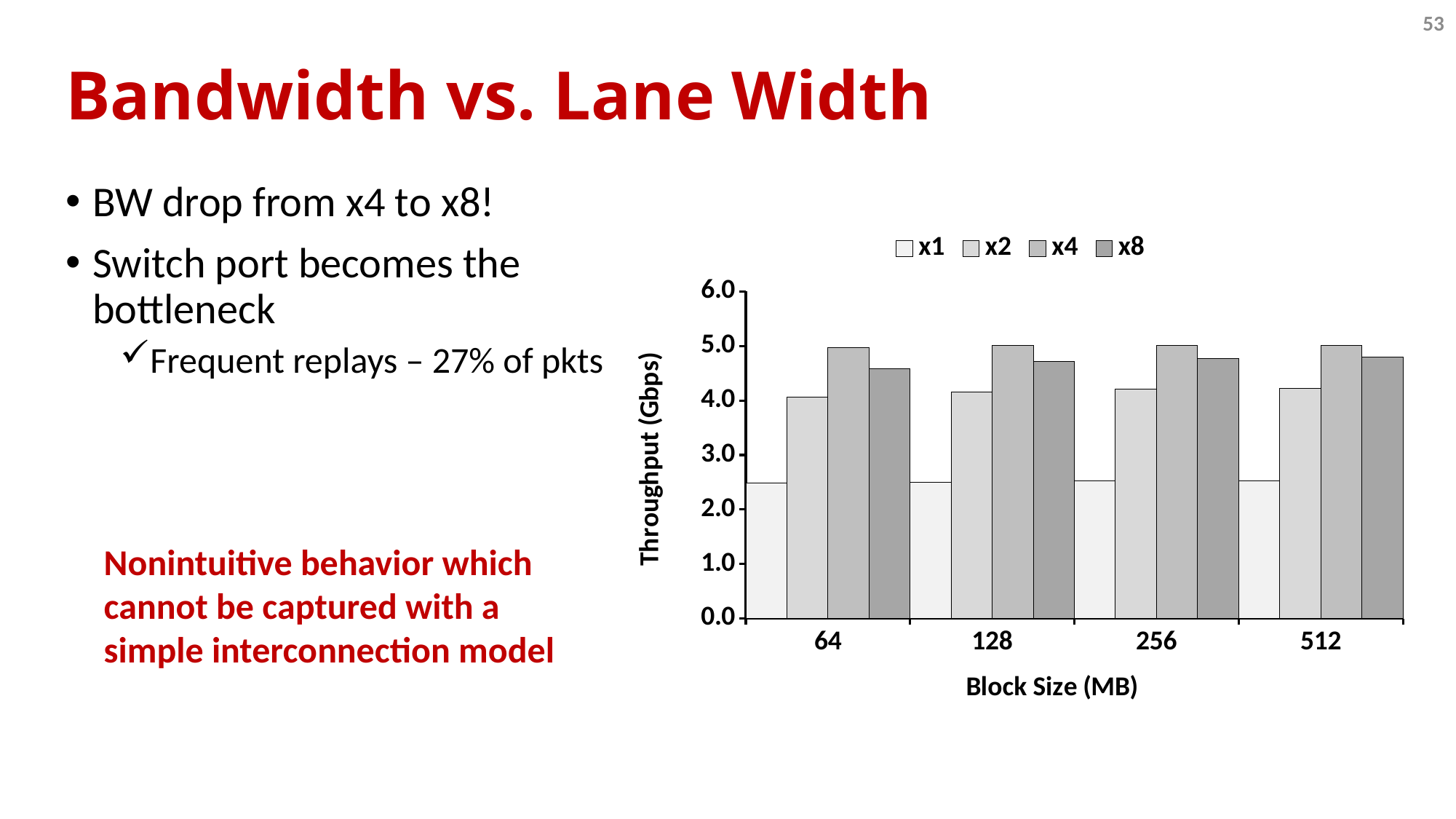
What is the label of the y axis? Throughput (Gbps) Is the throughput for x4 at block size 128 greater or less than 4.0? greater At block size 64, which is larger: the throughput for x4 or for x8? x4 Is the throughput for x1 at block size 64 greater or less than 3.0? less Which series has the lowest throughput at block size 256? x1 Is the throughput for x8 at block size 512 greater or less than 4.0? greater What kind of chart is shown on the slide? bar chart How many block size categories are shown on the x axis? 4 What is the label of the x axis? Block Size (MB) Which series has the highest throughput at block size 64? x4 At block size 128, which is larger: the throughput for x1 or for x2? x2 How many series does the legend list? 4